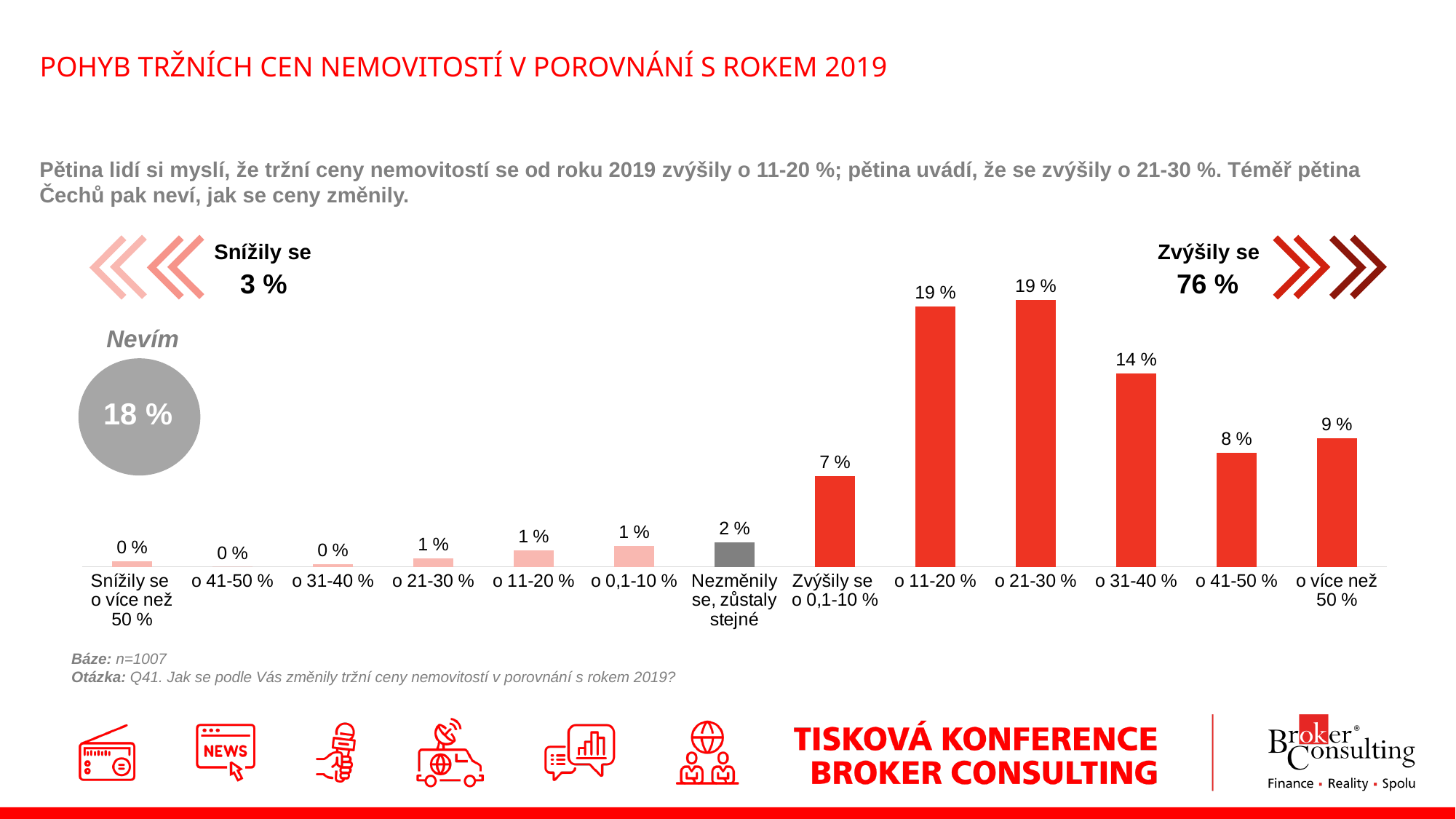
What is the total share of respondents who said prices increased ("Zvýšily se"), as shown on the slide? 76 % What percentage is shown for "Zvýšily se o 0,1-10 %"? 7 % What is the sample size (Báze) stated below the chart? n=1007 Which is larger: the value for "Zvýšily se o 0,1-10 %" or the value for "Nezměnily se, zůstaly stejné"? Zvýšily se o 0,1-10 % How many categories (bars) are shown on the x axis of the chart? 13 Which is larger: the value for "Zvýšily se o 31-40 %" or the value for "Zvýšily se o 41-50 %"? Zvýšily se o 31-40 % What is the difference between the value for "Zvýšily se o 31-40 %" (14 %) and "Zvýšily se o 41-50 %" (8 %)? 6 % What value is shown for the bar "Nezměnily se, zůstaly stejné"? 2 % What percentage of respondents said property prices increased by 11-20 % ("Zvýšily se o 11-20 %")? 19 % What value is shown for the bar "o více než 50 %" on the increase (Zvýšily se) side? 9 % What share of respondents answered "Nevím" (don't know)? 18 % What kind of chart is shown on the slide? Bar chart